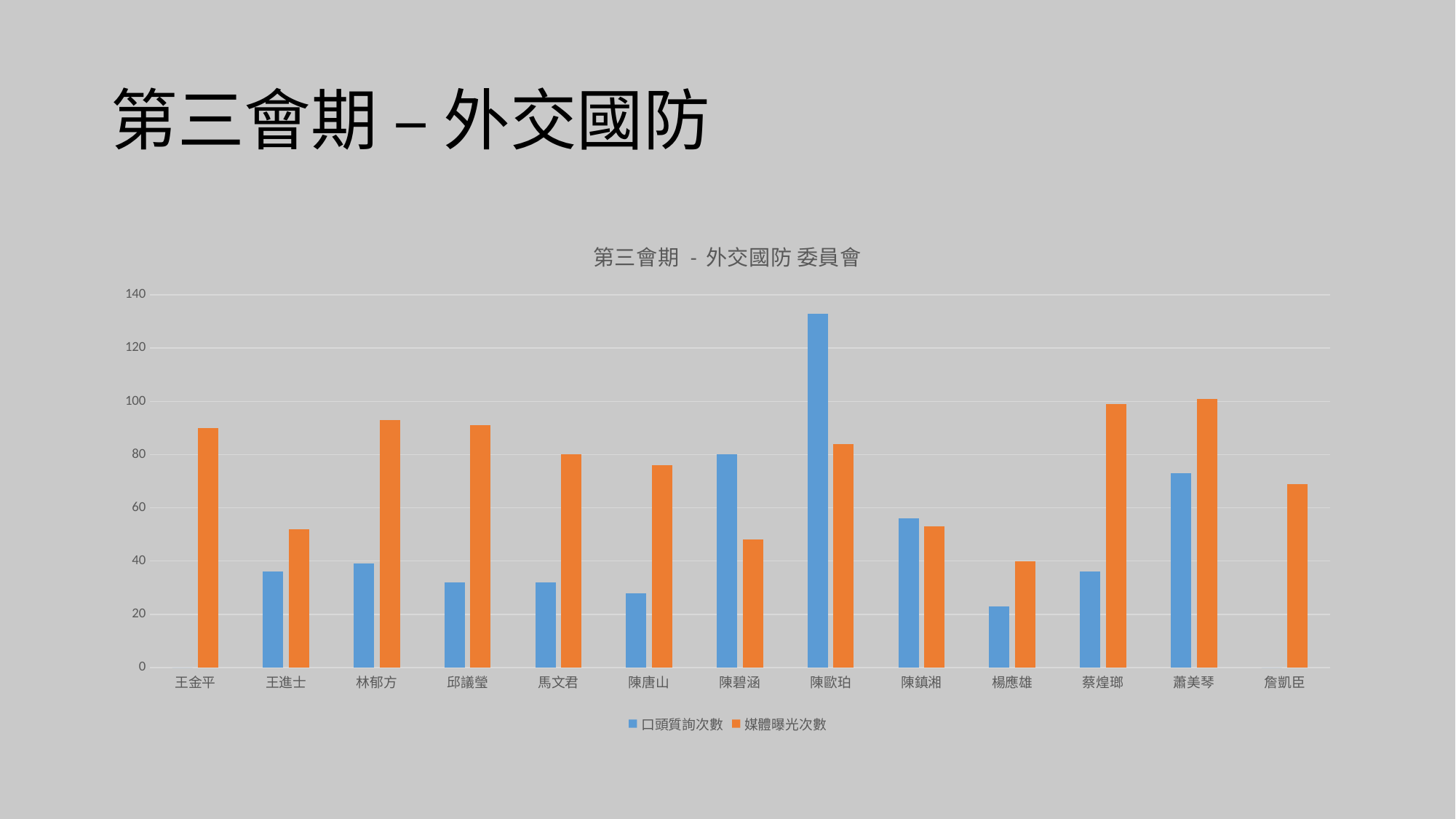
What is the title of the chart? 第三會期 - 外交國防 委員會 Which legislator has the highest 口頭質詢次數 value? 陳歐珀 How many legislators (categories) are shown on the x axis of the chart? 13 How many series does the chart's legend list? 2 Is the 口頭質詢次數 value for 陳歐珀 greater or less than 120? greater Is the 媒體曝光次數 value for 林郁方 greater or less than 80? greater For 蔡煌瑯, which is larger: 口頭質詢次數 or 媒體曝光次數? 媒體曝光次數 For 陳歐珀, which is larger: 口頭質詢次數 or 媒體曝光次數? 口頭質詢次數 Is the 媒體曝光次數 value for 詹凱臣 greater or less than 80? less What kind of chart is shown on the slide? Bar chart Which colour represents 媒體曝光次數 in the chart? Orange